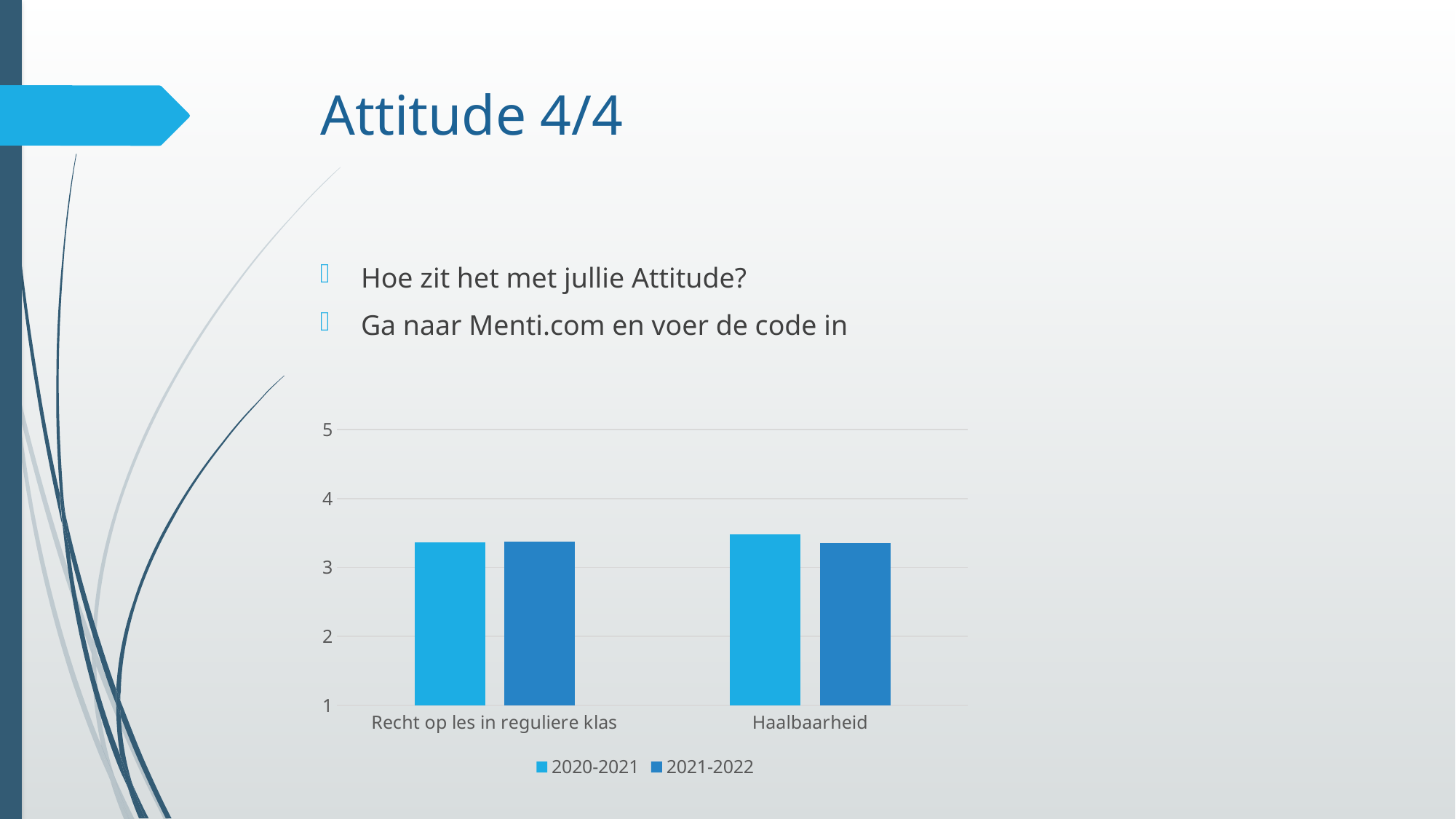
Is the value for 2021-2022 in the category Haalbaarheid greater or less than 3? greater How many categories are shown on the x axis of the chart? 2 Is the value for 2020-2021 in the category Recht op les in reguliere klas greater or less than 3? greater Is the value for 2020-2021 in the category Haalbaarheid greater or less than 2? greater What kind of chart is shown on the slide? bar chart How many series does the chart legend list? 2 Which category is shown on the left of the x axis? Recht op les in reguliere klas What are the two series named in the chart legend? 2020-2021 and 2021-2022